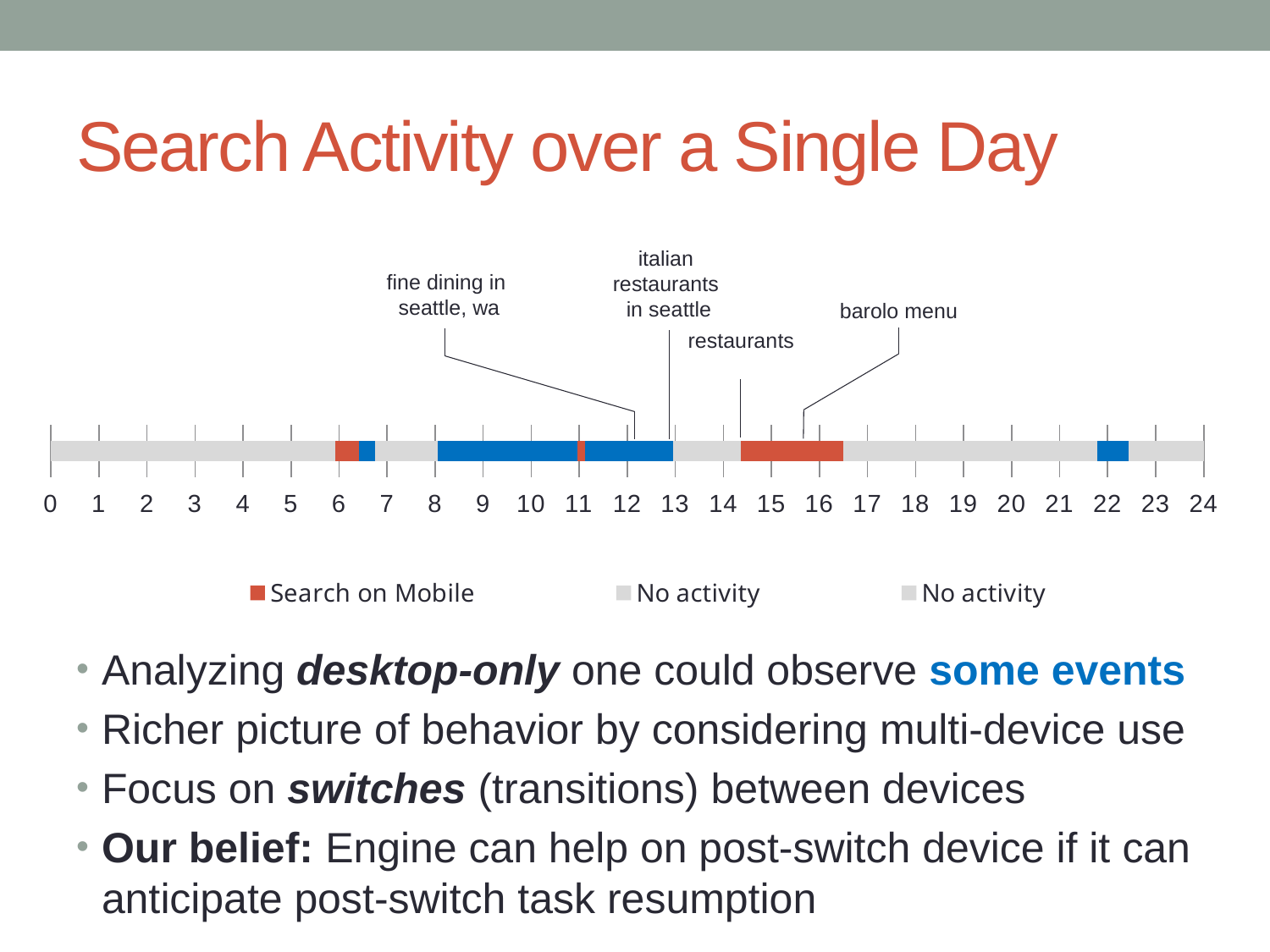
How many entries does the chart's legend list? 3 What kind of chart is shown on the slide? bar chart Which annotated query occurs latest in the day on the chart? barolo menu What colour does the legend use for 'Search on Mobile'? red Is the time of the 'barolo menu' query on the chart greater or less than 14? greater Is the time of the 'restaurants' query on the chart greater or less than 15? less What is the highest value labelled on the chart's horizontal axis? 24 Which annotated query occurs earliest in the day on the chart? fine dining in seattle, wa How many tick labels are shown along the chart's horizontal axis? 25 What is the title of the chart on the slide? Search Activity over a Single Day How many search queries are annotated with text labels on the chart? 4 What is the lowest value labelled on the chart's horizontal axis? 0